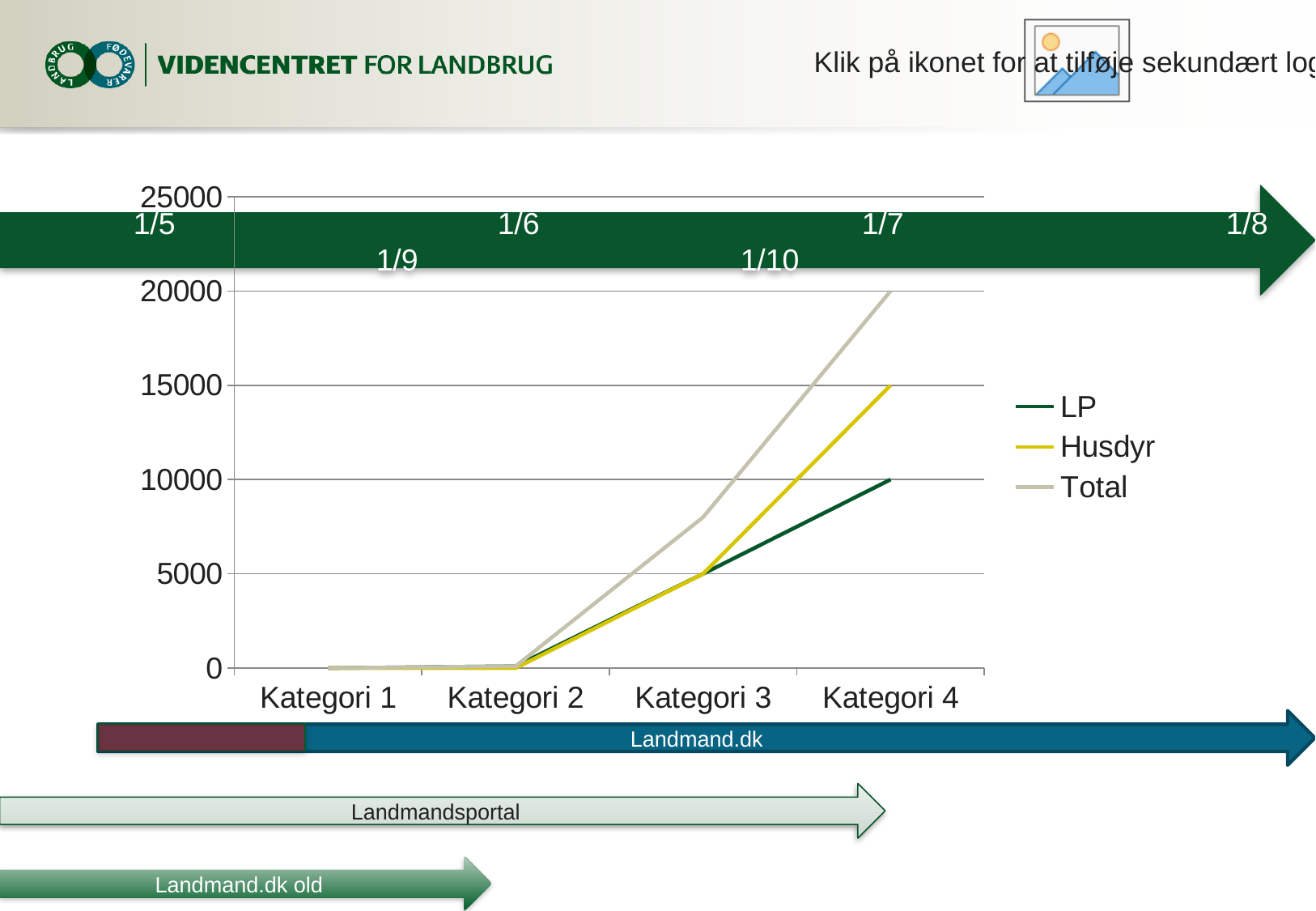
What is the value of the LP series at Kategori 4? 10000 What kind of chart is shown on the slide? line chart Is the value of the Total series at Kategori 3 greater or less than 10000? less How many categories are shown on the x axis of the chart? 4 Do the values of the Total series rise or fall from Kategori 1 to Kategori 4? rise What is the value of the Total series at Kategori 4? 20000 At Kategori 4, which is larger: the Husdyr value or the LP value? Husdyr How many series does the chart legend list? 3 Which series has the highest value at Kategori 4? Total Is the value of the Total series at Kategori 3 greater or less than 5000? greater What is the value of the Husdyr series at Kategori 4? 15000 Which series has the lowest value at Kategori 4? LP